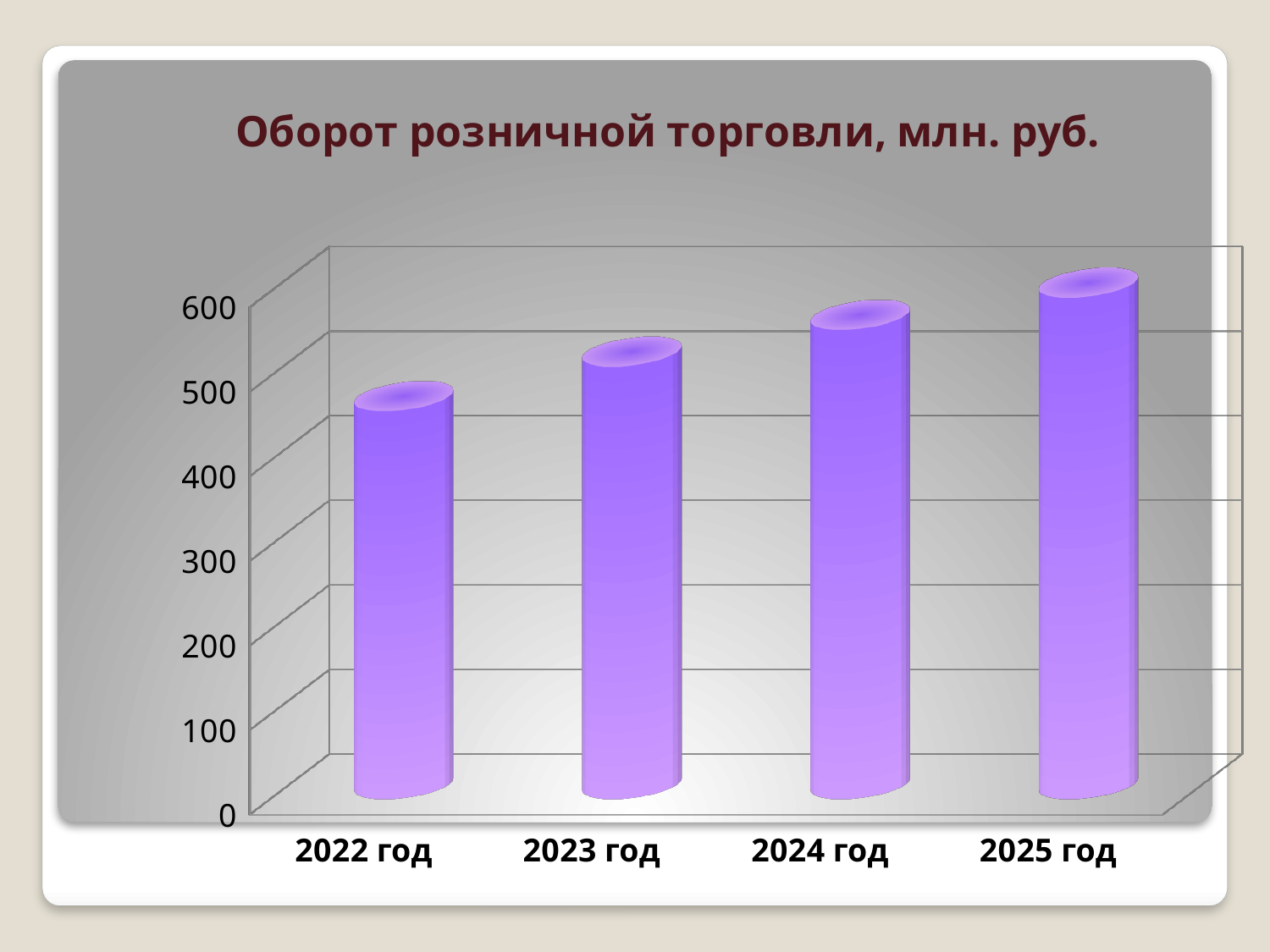
Is the value for 2022 год greater or less than 400? greater What kind of chart is shown on the slide? bar chart Which is larger, the value for 2022 год or the value for 2025 год? 2025 год Which is larger, the value for 2023 год or the value for 2024 год? 2024 год How many categories (years) are shown on the x axis? 4 What is the title of the chart? Оборот розничной торговли, млн. руб. Which year has the highest retail trade turnover? 2025 год Is the value for 2024 год greater or less than 500? greater Which year has the lowest retail trade turnover? 2022 год Do the values rise or fall from 2022 год to 2025 год? rise